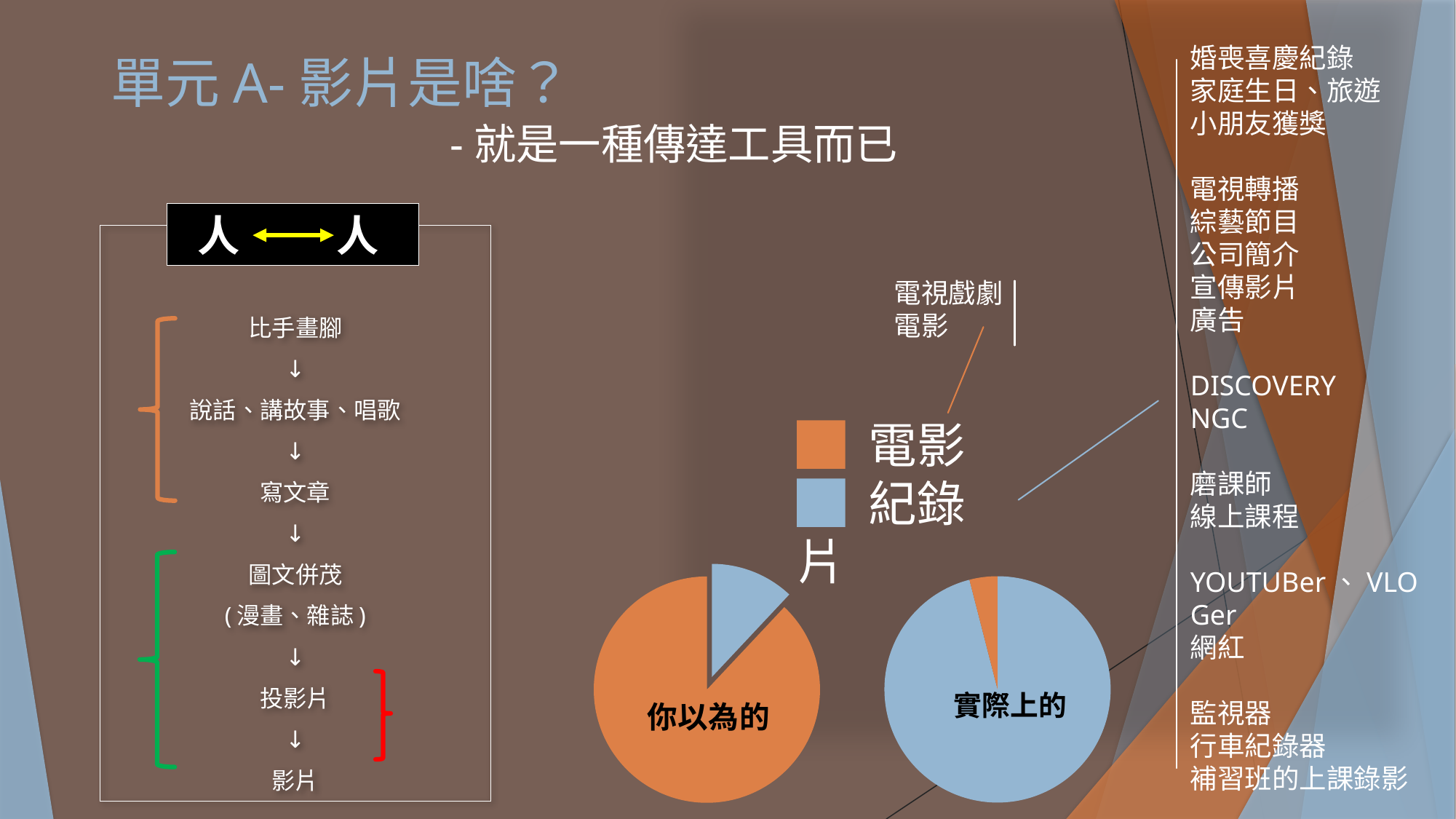
In the "實際上的" pie chart, which category has the largest share? 紀錄片 How many entries does the shared legend list for the pie charts? 2 In the "你以為的" pie chart, which slice is larger, 電影 or 紀錄片? 電影 What kind of chart is the "實際上的" chart? pie chart In the "實際上的" pie chart, which slice is larger, 電影 or 紀錄片? 紀錄片 In the "實際上的" pie chart, which category has the smallest share? 電影 How many slices does the "實際上的" pie chart have? 2 What kind of chart is the "你以為的" chart? pie chart Which colour represents 紀錄片 in the pie charts' legend? blue Which colour represents 電影 in the pie charts' legend? orange How many slices does the "你以為的" pie chart have? 2 In the "你以為的" pie chart, which category has the smallest share? 紀錄片